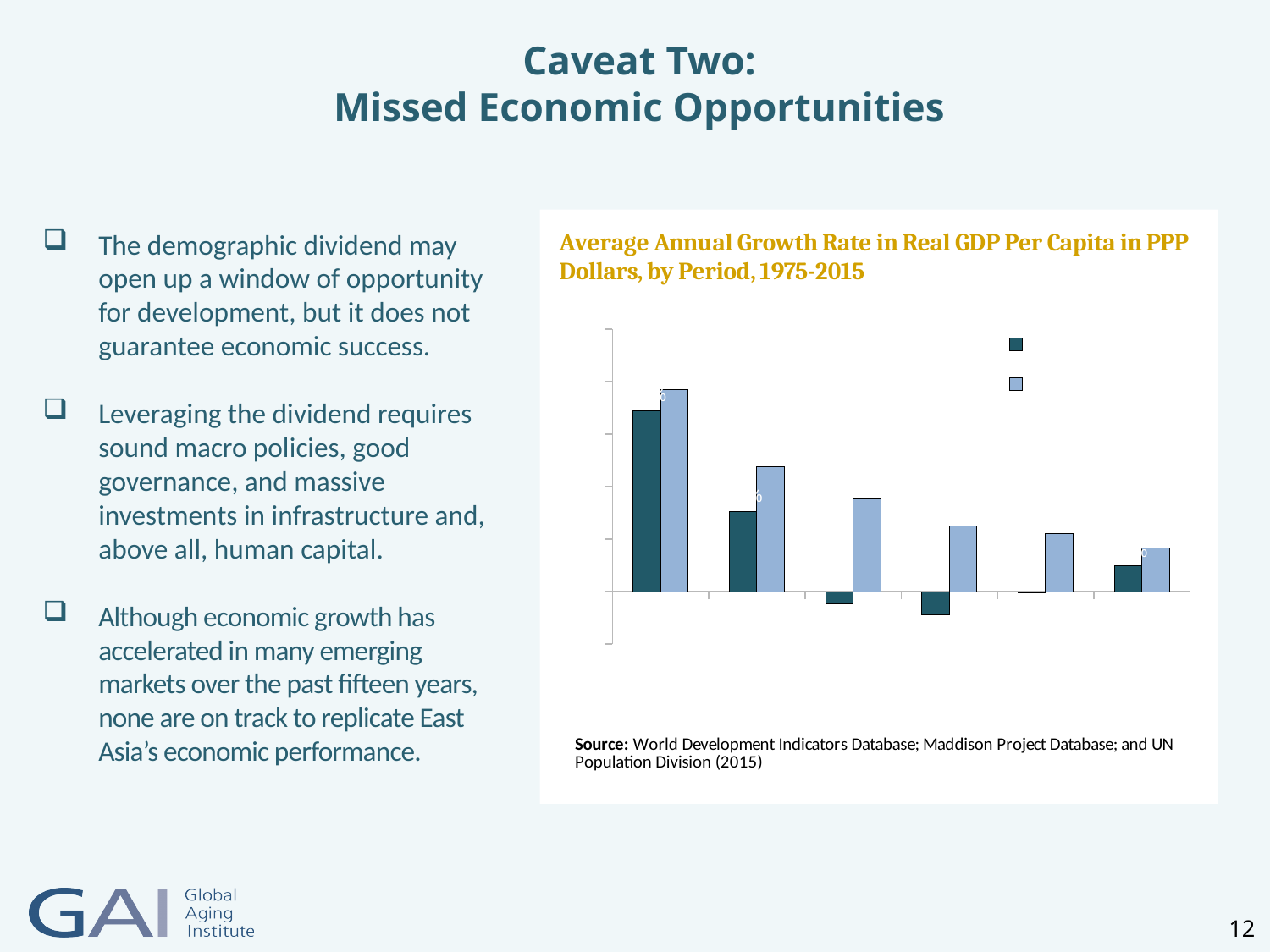
In the leftmost group of bars, which is taller: the dark teal bar or the light blue bar? the light blue bar What kind of chart is shown on the slide? bar chart What is the title of the chart? Average Annual Growth Rate in Real GDP Per Capita in PPP Dollars, by Period, 1975-2015 How many groups of bars are plotted along the x axis? 6 Which group of bars, counting from the left, has the tallest bars in the chart? the first (leftmost) group Do the light blue bars rise or fall from left to right along the x axis? fall How many series does the chart's legend list? 2 Which series has bars that extend below the zero line: the dark teal series or the light blue series? the dark teal series